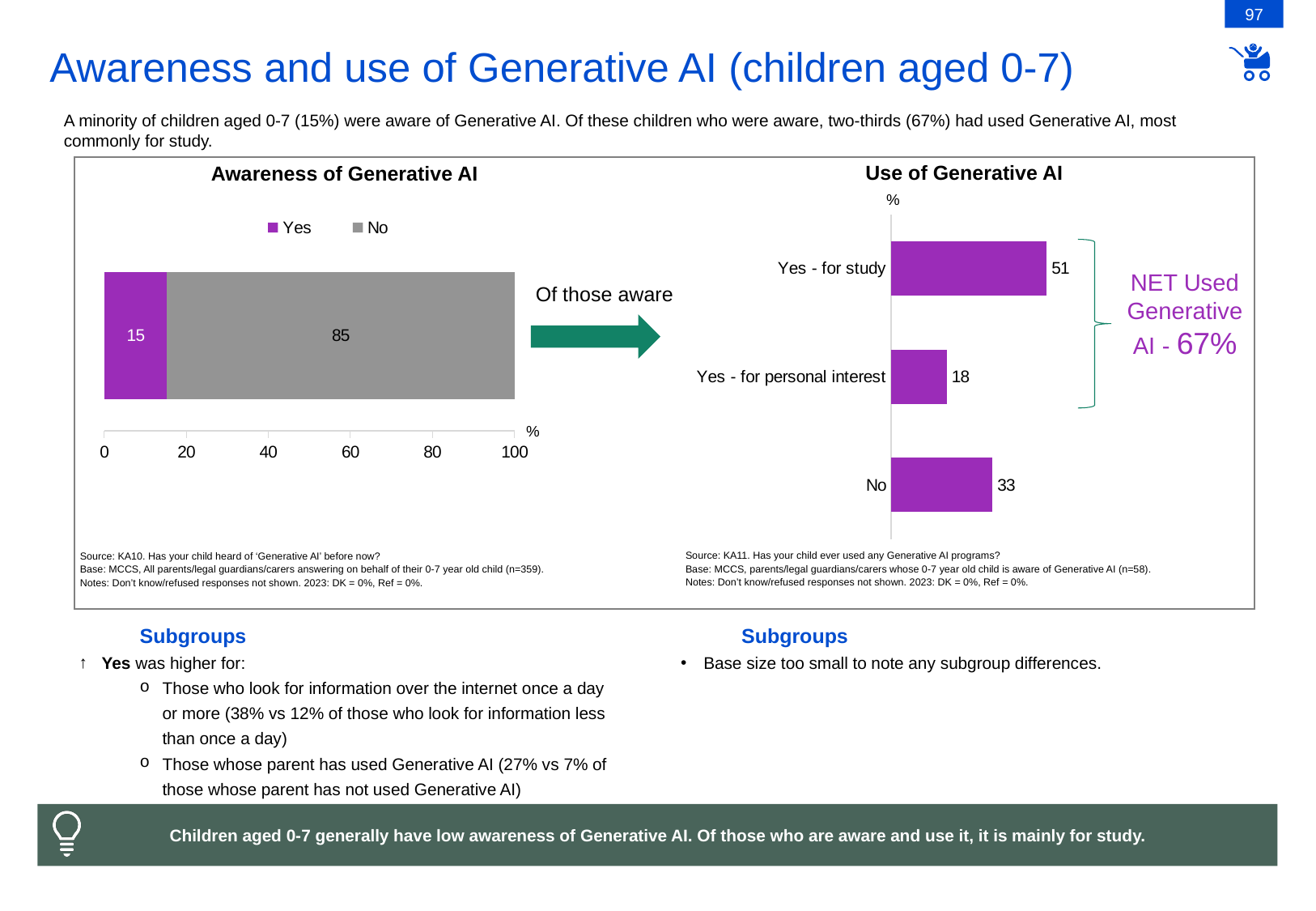
In the 'Awareness of Generative AI' chart, how many series does the legend list? 2 In the 'Use of Generative AI' chart, what is the value for 'No'? 33 In the 'Use of Generative AI' chart, how many categories are shown? 3 What kind of chart is the 'Use of Generative AI' chart? Bar chart In the 'Use of Generative AI' chart, which category has the lowest value? Yes - for personal interest In the 'Awareness of Generative AI' chart, what is the difference between the No and Yes values? 70 In the 'Awareness of Generative AI' chart, what percentage of children answered No? 85 In the 'Awareness of Generative AI' chart, what is the total of the stacked bar? 100 In the 'Use of Generative AI' chart, what is the value for 'Yes - for study'? 51 In the 'Use of Generative AI' chart, what is the value for 'Yes - for personal interest'? 18 In the 'Use of Generative AI' chart, which category has the highest value? Yes - for study In the 'Awareness of Generative AI' chart, what percentage of children answered Yes? 15